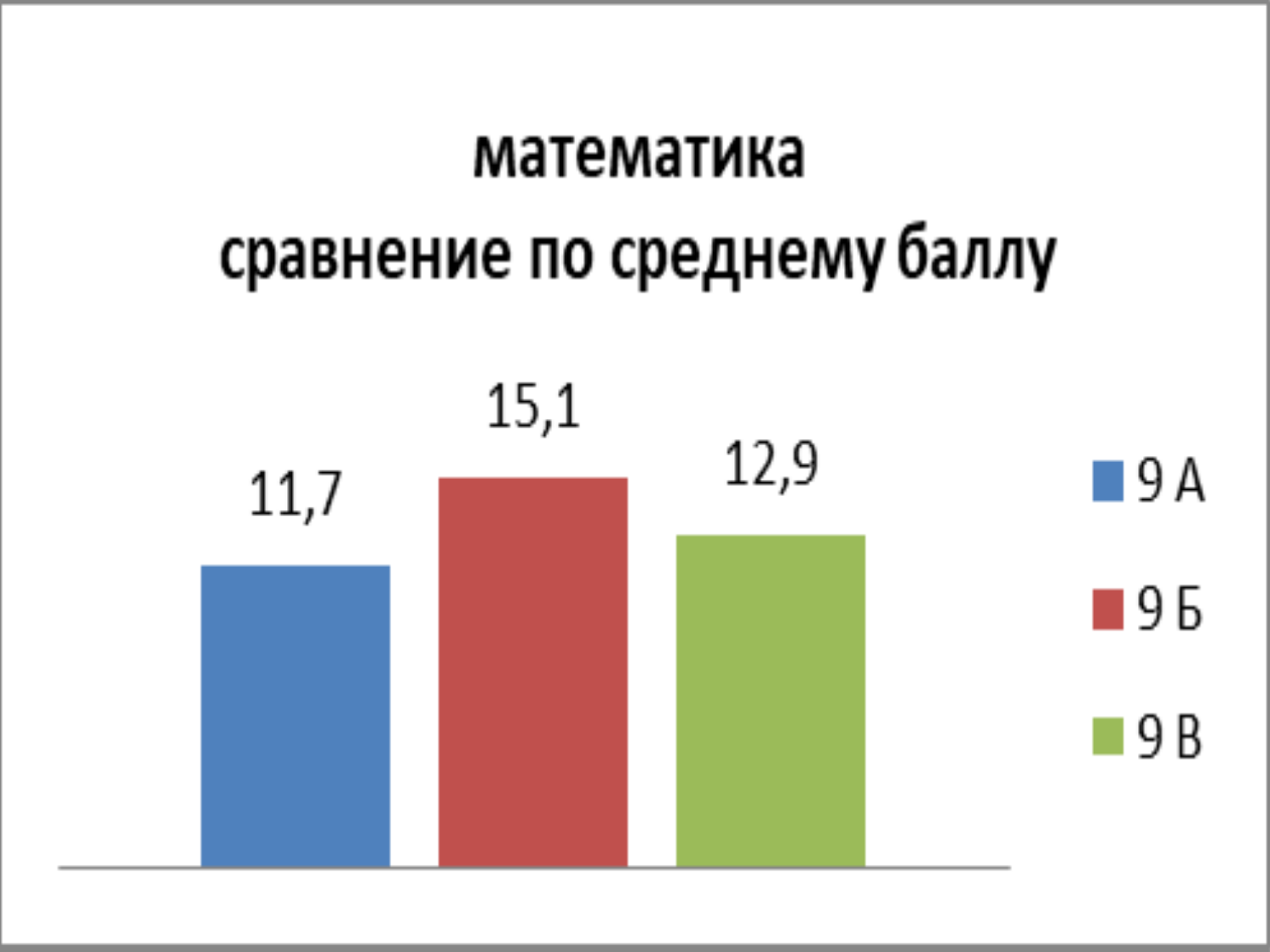
What is the average score shown for 9 В? 12,9 What is the title of the chart? математика сравнение по среднему баллу What is the difference between the average scores of 9 Б and 9 А? 3,4 What is the average score shown for 9 Б? 15,1 What is the average score shown for 9 А? 11,7 What is the difference between the average scores of 9 Б and 9 В? 2,2 Which class has the highest average score? 9 Б What kind of chart is shown on the slide? Bar chart Which has a higher average score, 9 А or 9 В? 9 В How many classes are shown in the chart? 3 Which class has the lowest average score? 9 А What is the difference between the average scores of 9 В and 9 А? 1,2